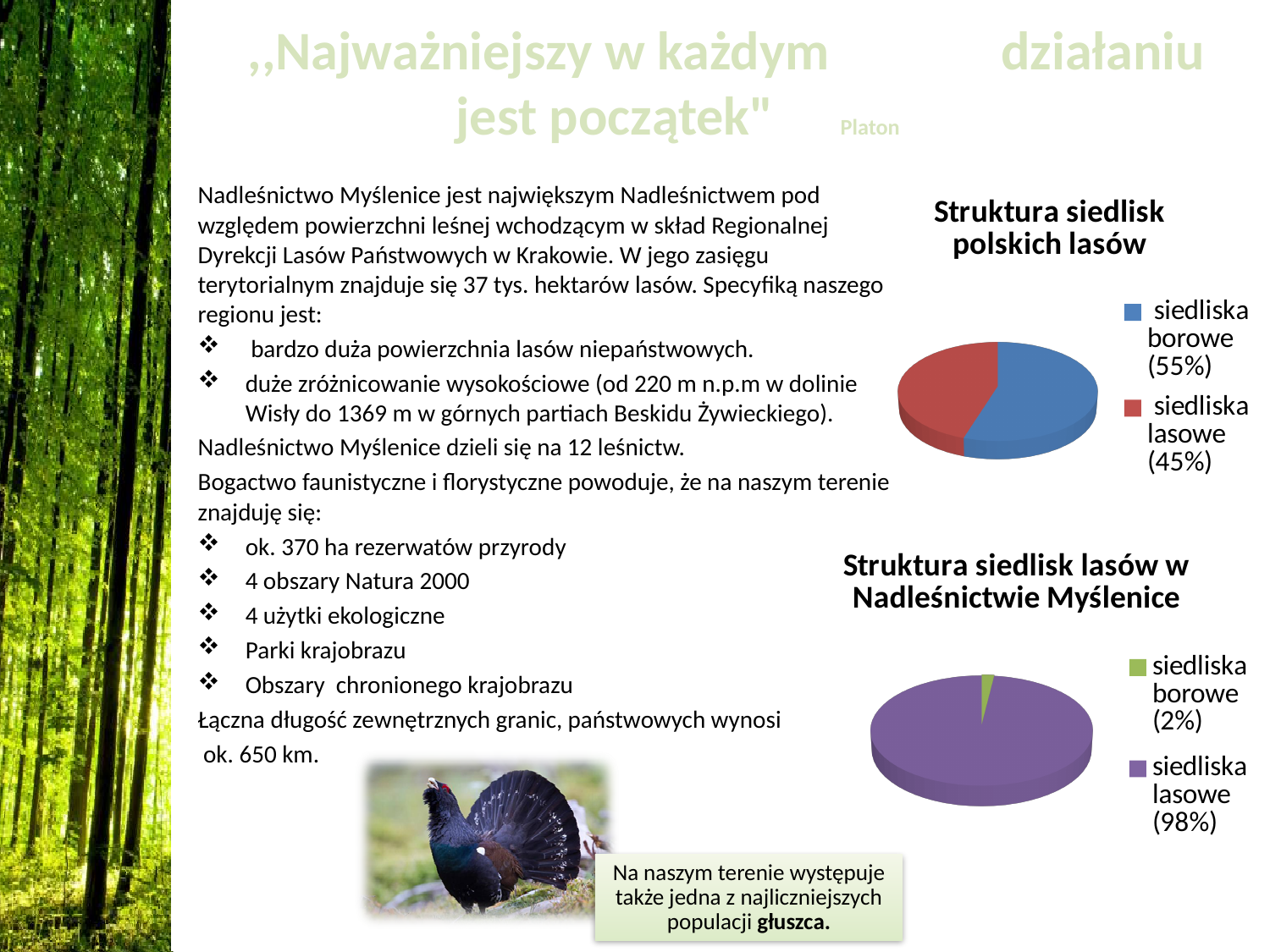
What type of chart is the chart titled "Struktura siedlisk lasów w Nadleśnictwie Myślenice"? pie chart In the chart titled "Struktura siedlisk polskich lasów", which is larger: siedliska borowe or siedliska lasowe? siedliska borowe In the chart titled "Struktura siedlisk polskich lasów", which category has the largest slice? siedliska borowe In the chart titled "Struktura siedlisk lasów w Nadleśnictwie Myślenice", what is the difference in percentage points between siedliska lasowe and siedliska borowe? 96 percentage points In the chart titled "Struktura siedlisk polskich lasów", what share do siedliska borowe have? 55% How many categories does the chart titled "Struktura siedlisk polskich lasów" show? 2 In the chart titled "Struktura siedlisk polskich lasów", what share do siedliska lasowe have? 45% In the chart titled "Struktura siedlisk lasów w Nadleśnictwie Myślenice", which category has the smallest slice? siedliska borowe In the chart titled "Struktura siedlisk lasów w Nadleśnictwie Myślenice", what share do siedliska lasowe have? 98% In the chart titled "Struktura siedlisk lasów w Nadleśnictwie Myślenice", what colour is the slice for siedliska lasowe? purple In the chart titled "Struktura siedlisk polskich lasów", what is the difference in percentage points between siedliska borowe and siedliska lasowe? 10 percentage points